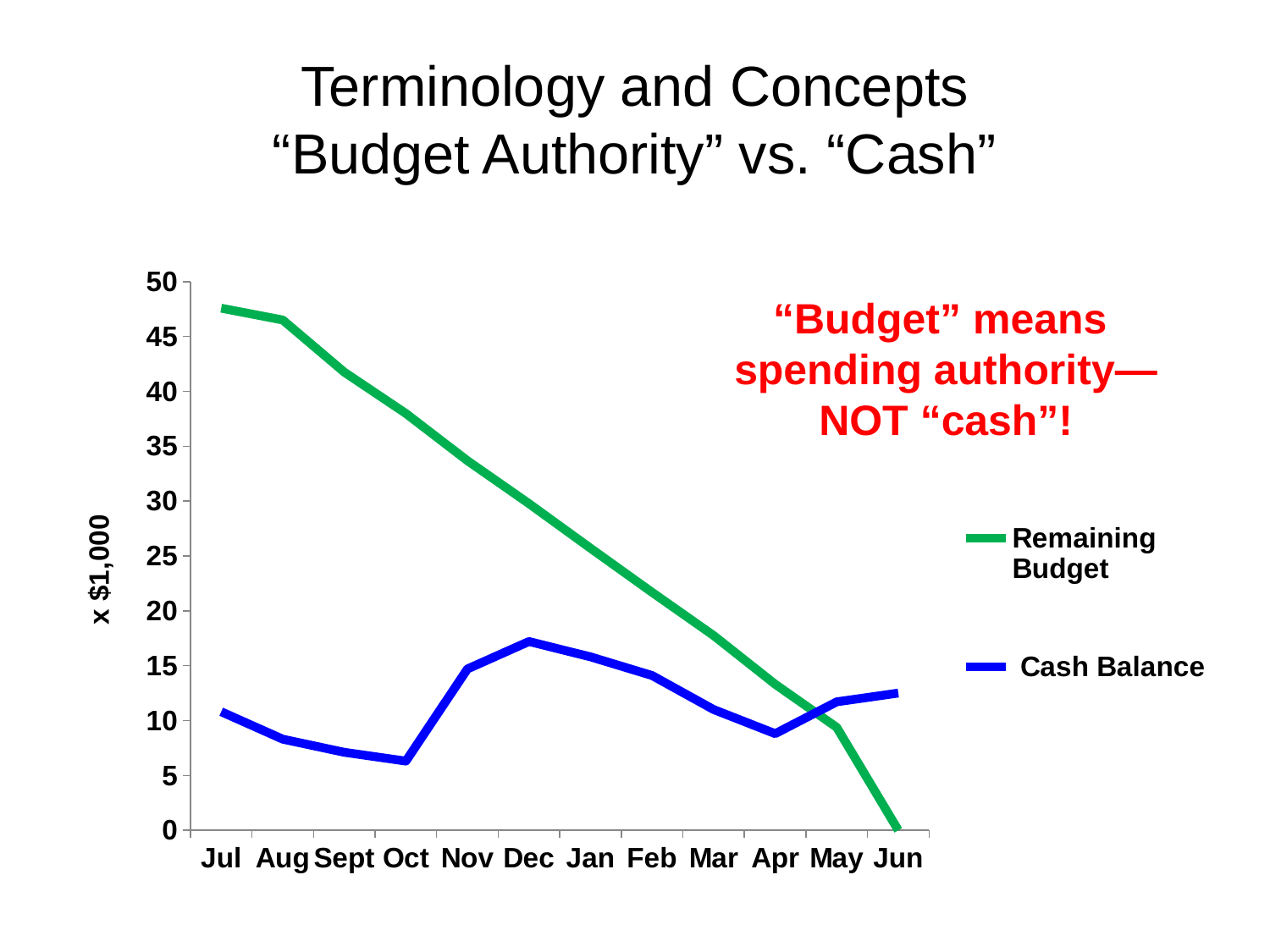
How many months are shown along the x axis? 12 Is the Remaining Budget value for Jul greater or less than 45? greater Does the Remaining Budget line rise or fall from Jul to Jun? fall In which month is the Cash Balance highest? Dec What is the Remaining Budget value in Jun? 0 Is the Cash Balance value for Dec greater or less than 15? greater How many series does the legend list? 2 Is the Cash Balance value for Oct greater or less than 10? less In Jun, which series has the larger value, Remaining Budget or Cash Balance? Cash Balance What is the label on the y axis? x $1,000 In which month is the Cash Balance lowest? Oct What kind of chart is shown on the slide? line chart